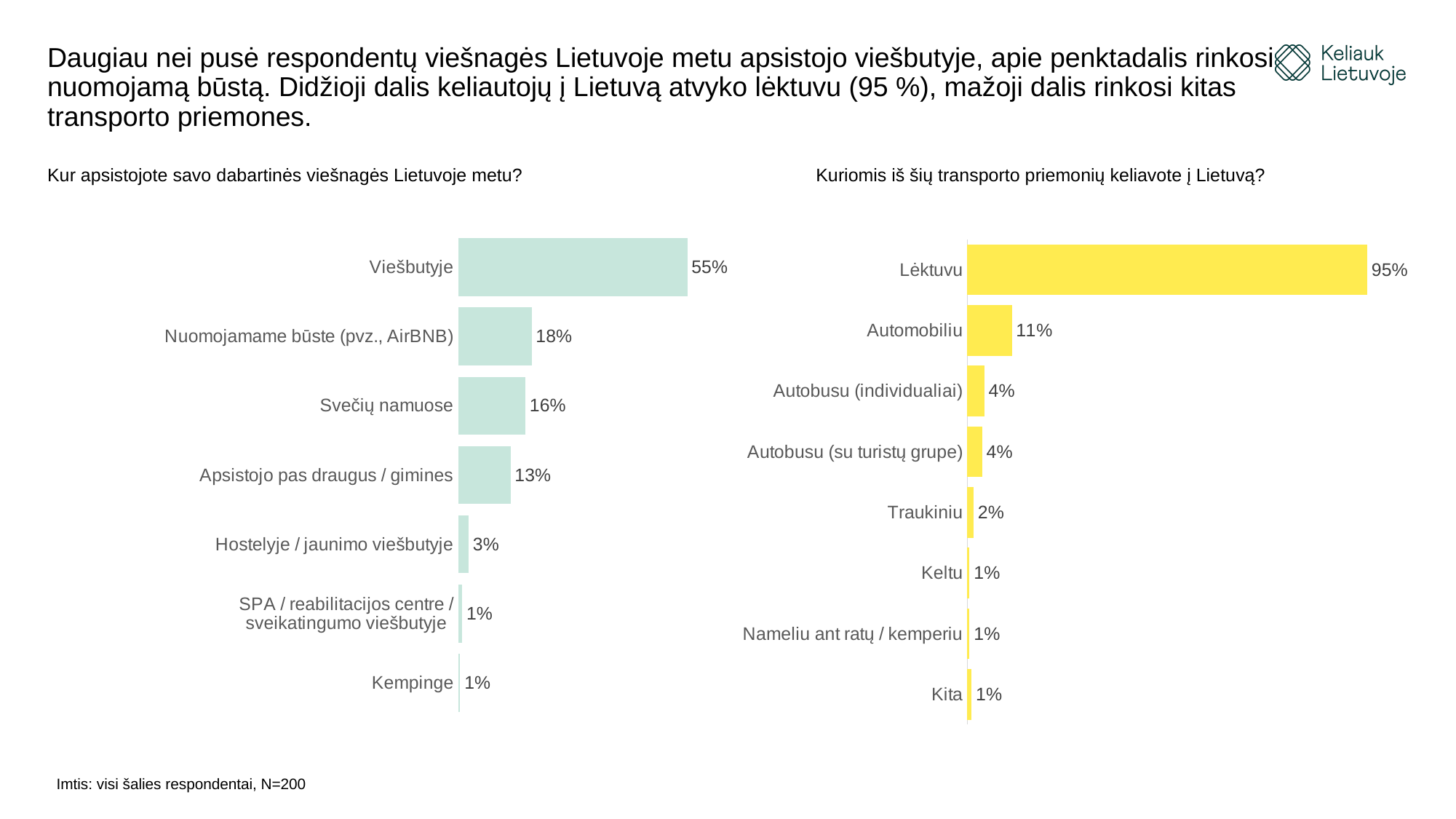
In the left chart (Kur apsistojote savo dabartinės viešnagės Lietuvoje metu?), what is the value for Viešbutyje? 55% In the left chart (Kur apsistojote savo dabartinės viešnagės Lietuvoje metu?), what is the value for Svečių namuose? 16% In the right chart (Kuriomis iš šių transporto priemonių keliavote į Lietuvą?), which category has the highest value? Lėktuvu In the left chart (Kur apsistojote savo dabartinės viešnagės Lietuvoje metu?), which is larger: Svečių namuose or Apsistojo pas draugus / gimines? Svečių namuose In the right chart (Kuriomis iš šių transporto priemonių keliavote į Lietuvą?), what is the difference between Lėktuvu and Automobiliu? 84% In the left chart (Kur apsistojote savo dabartinės viešnagės Lietuvoje metu?), which category has the highest value? Viešbutyje How many categories are shown in the right chart (Kuriomis iš šių transporto priemonių keliavote į Lietuvą?)? 8 How many categories are shown in the left chart (Kur apsistojote savo dabartinės viešnagės Lietuvoje metu?)? 7 In the right chart (Kuriomis iš šių transporto priemonių keliavote į Lietuvą?), what is the value for Automobiliu? 11% In the right chart (Kuriomis iš šių transporto priemonių keliavote į Lietuvą?), what is the value for Traukiniu? 2% What type of chart is the right chart (Kuriomis iš šių transporto priemonių keliavote į Lietuvą?)? Bar chart In the left chart (Kur apsistojote savo dabartinės viešnagės Lietuvoje metu?), what is the difference between Viešbutyje and Nuomojamame būste (pvz., AirBNB)? 37%